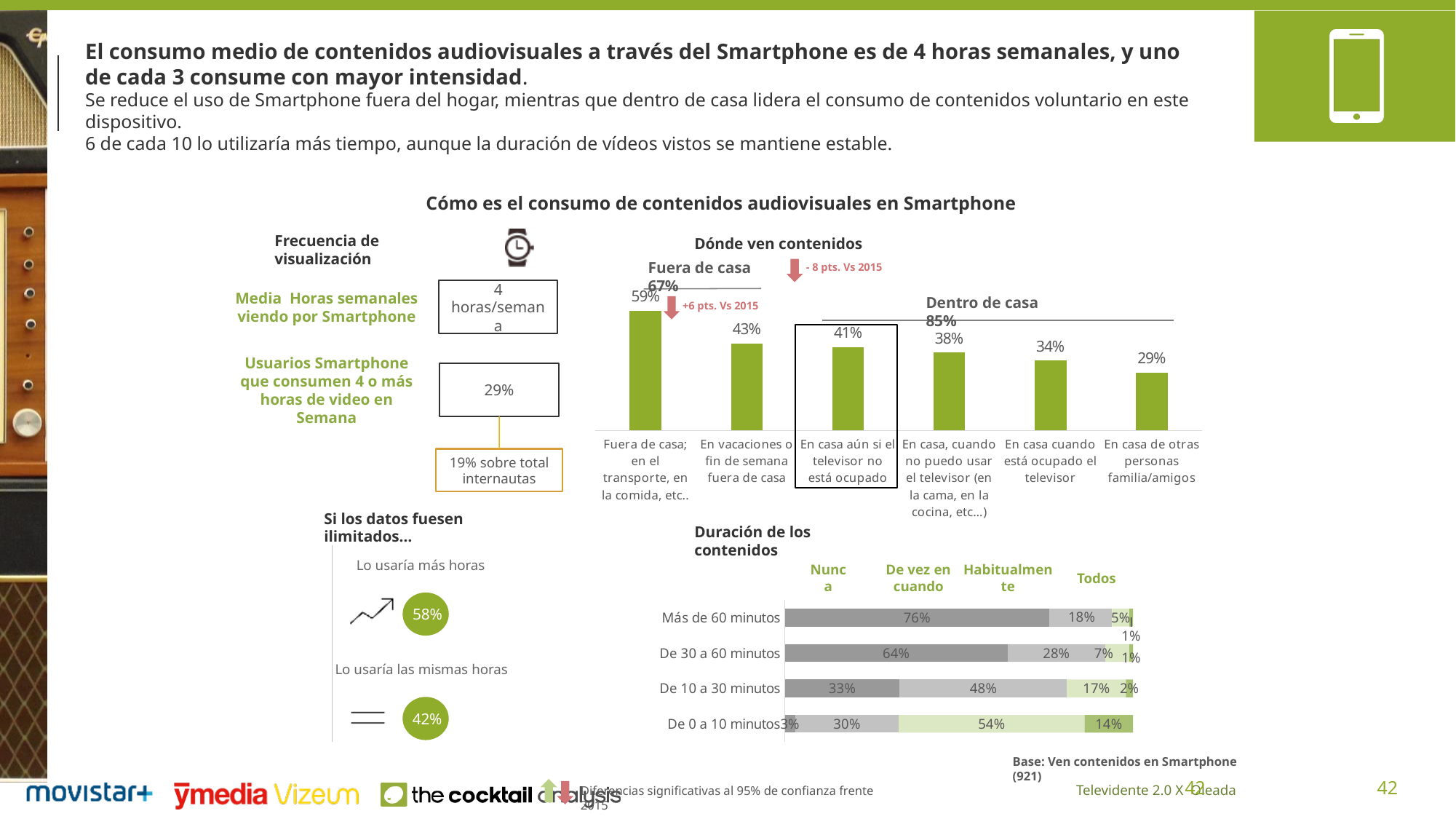
In the 'Dónde ven contenidos' chart, which category has the lowest value? En casa de otras personas familia/amigos In the 'Duración de los contenidos' chart, what is the 'Habitualmente' value for 'De 0 a 10 minutos'? 54% In the 'Dónde ven contenidos' chart, which category has the highest value? Fuera de casa; en el transporte, en la comida, etc.. In the 'Duración de los contenidos' chart, what is the 'Nunca' value for 'Más de 60 minutos'? 76% In the 'Dónde ven contenidos' chart, what is the difference between 'En vacaciones o fin de semana fuera de casa' and 'En casa aún si el televisor no está ocupado'? 2% What kind of chart is 'Duración de los contenidos'? stacked bar chart In the 'Duración de los contenidos' chart, which is larger: the 'De vez en cuando' value for 'De 10 a 30 minutos' or for 'De 30 a 60 minutos'? De 10 a 30 minutos In the 'Dónde ven contenidos' chart, what is the value for 'En casa cuando está ocupado el televisor'? 34% In the 'Dónde ven contenidos' chart, do the values rise or fall from left to right? fall In the 'Dónde ven contenidos' chart, how many categories are shown? 6 In the 'Duración de los contenidos' chart, how many series does the legend list? 4 In the 'Dónde ven contenidos' chart, what is the value for 'Fuera de casa; en el transporte, en la comida, etc..'? 59%